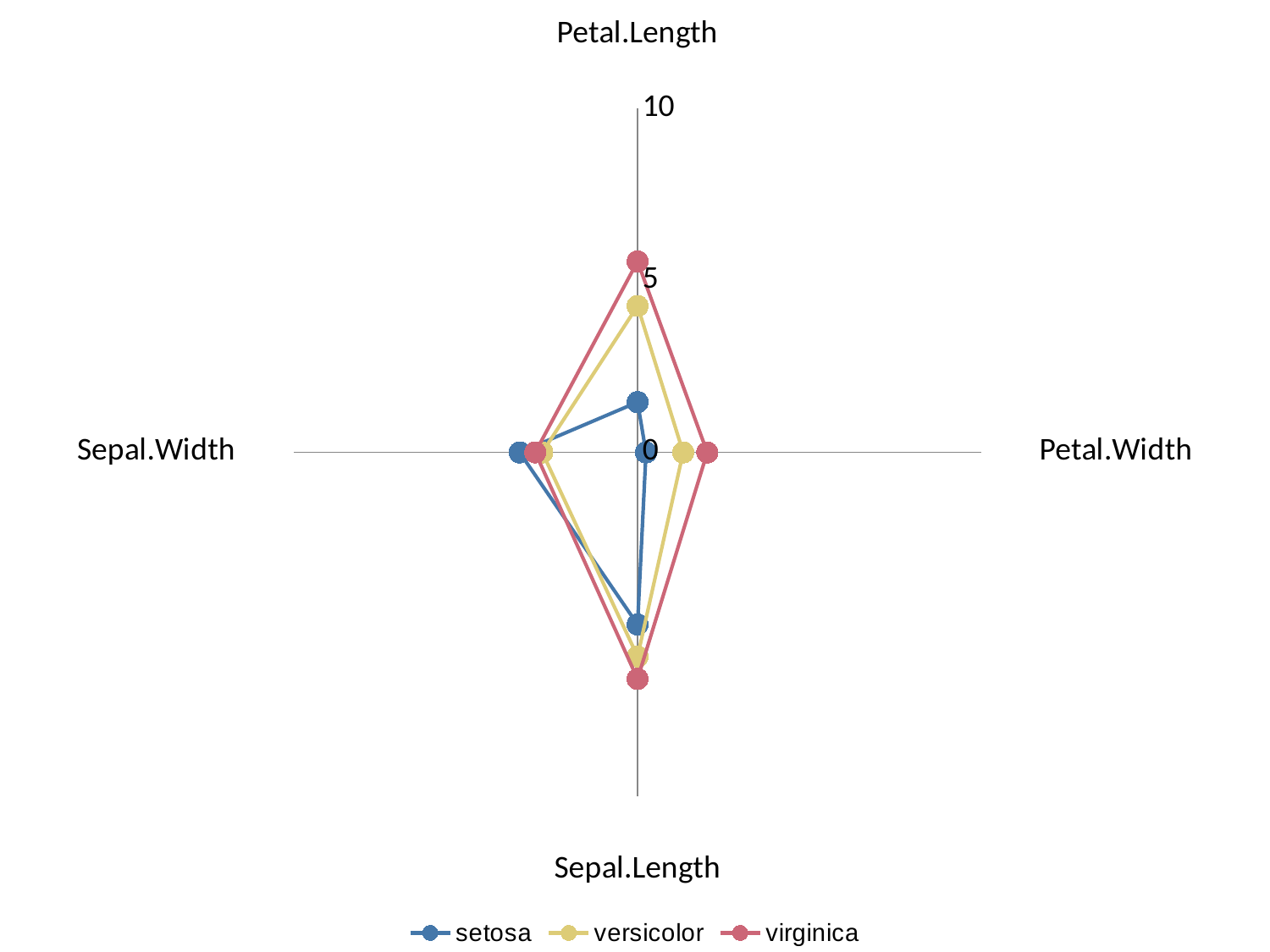
How many series does the legend list? 3 Is the Sepal.Length value for virginica greater or less than 5? greater Which series has the lowest value on the Petal.Width axis? setosa Which series has the highest value on the Sepal.Width axis? setosa On the Petal.Width axis, which is larger: the value for virginica or the value for setosa? virginica Is the Petal.Length value for setosa greater or less than 5? less What is the maximum value shown on the radar chart's axis scale? 10 Which series has the lowest value on the Petal.Length axis? setosa How many axes (categories) does the radar chart have? 4 Which series has the highest value on the Sepal.Length axis? virginica Which series has the highest value on the Petal.Length axis? virginica What kind of chart is shown on the slide? Radar chart